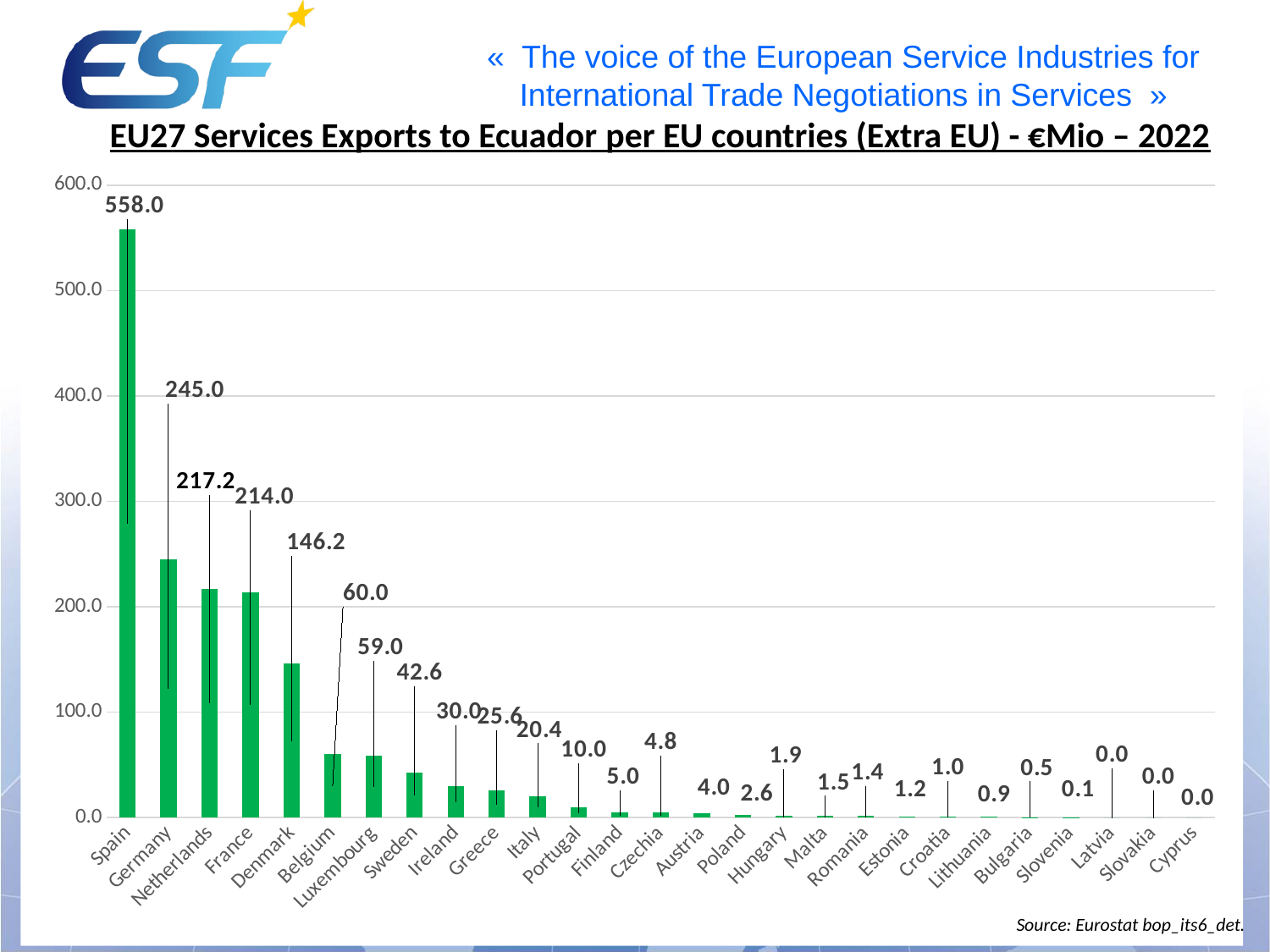
Which has the larger value, Belgium or Luxembourg? Belgium What is the value for Portugal? 10.0 What is the value for Czechia? 4.8 How many countries show a value of 0.0? 3 What is the value for Denmark? 146.2 What is the difference between the values for Spain and Germany? 313.0 What kind of chart is this? Bar chart Do the values rise or fall from left to right along the x axis? Fall How many countries are shown on the x axis? 27 Which country has the highest value? Spain What is the difference between the values for Germany and the Netherlands? 27.8 What is the value for Spain? 558.0